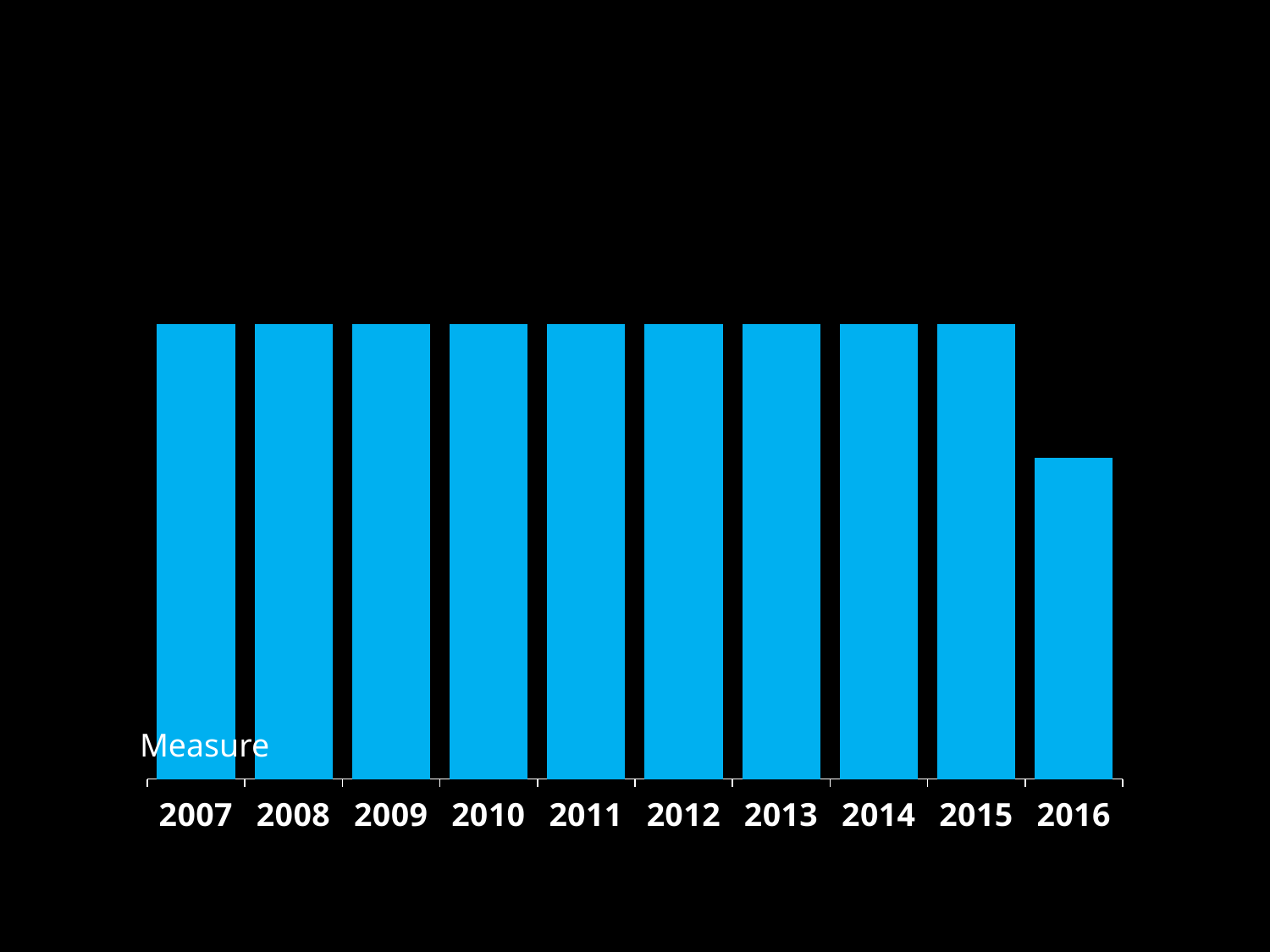
Which is larger, the value for 2015 or the value for 2016? 2015 Does the value fall or rise from 2015 to 2016? fall Is the bar for 2016 taller or shorter than the bar for 2010? shorter Which year has the lowest bar in the chart? 2016 Do the bars from 2007 to 2015 change in height or stay roughly the same? stay roughly the same What text label appears at the bottom left of the plot area? Measure Which is larger, the value for 2007 or the value for 2016? 2007 What is the first year shown on the x axis? 2007 How many years are shown on the x axis of the chart? 10 What kind of chart is shown on the slide? bar chart